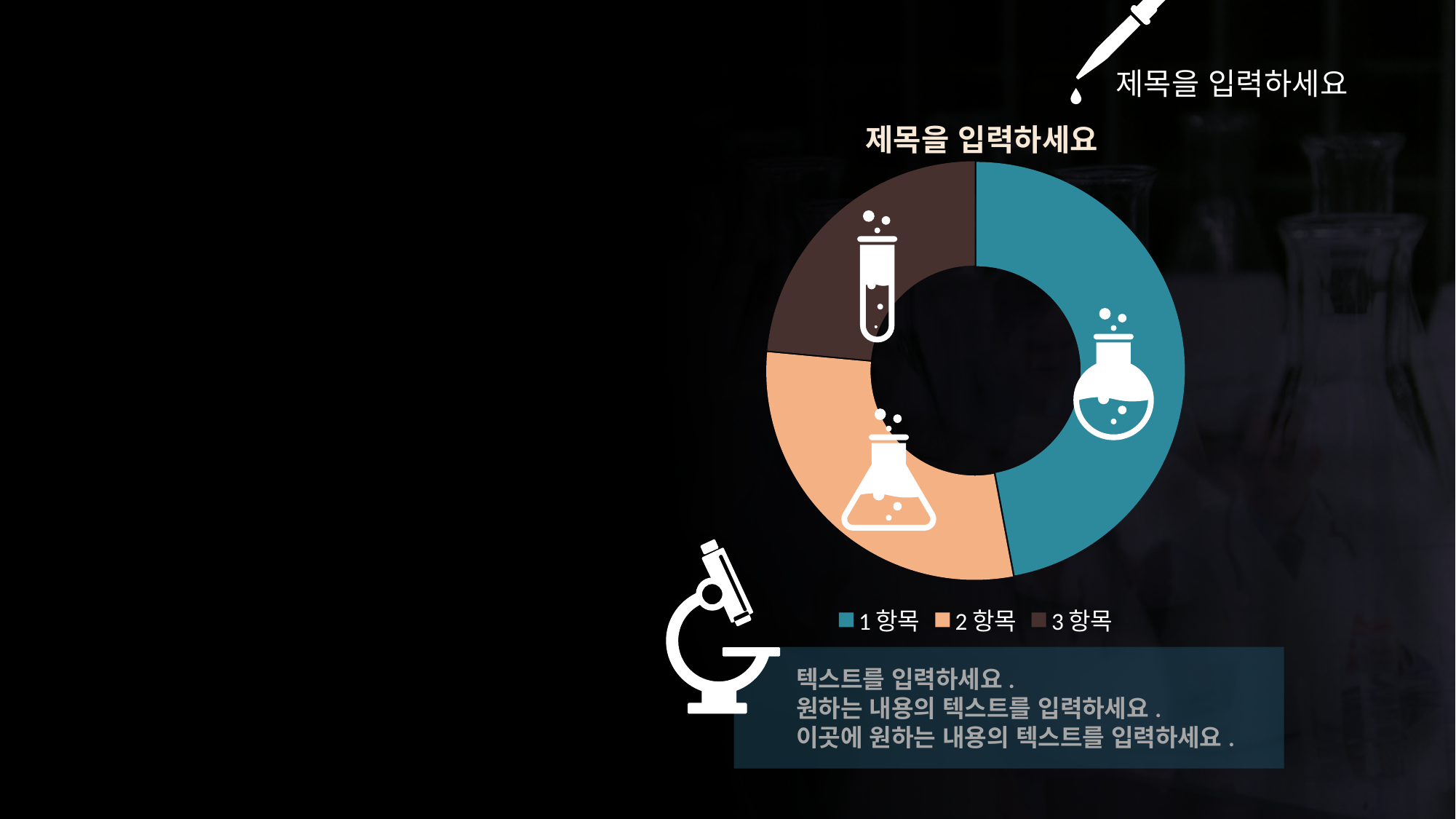
What kind of chart is shown on the slide? Doughnut chart How many slices does the doughnut chart have? 3 Which slice is larger in the doughnut chart, 1 항목 or 3 항목? 1 항목 Which category has the largest slice in the doughnut chart? 1 항목 What is the title of the doughnut chart? 제목을 입력하세요 How many entries does the legend of the doughnut chart list? 3 Which slice is larger in the doughnut chart, 1 항목 or 2 항목? 1 항목 What colour is the slice for 2 항목 in the doughnut chart? Orange